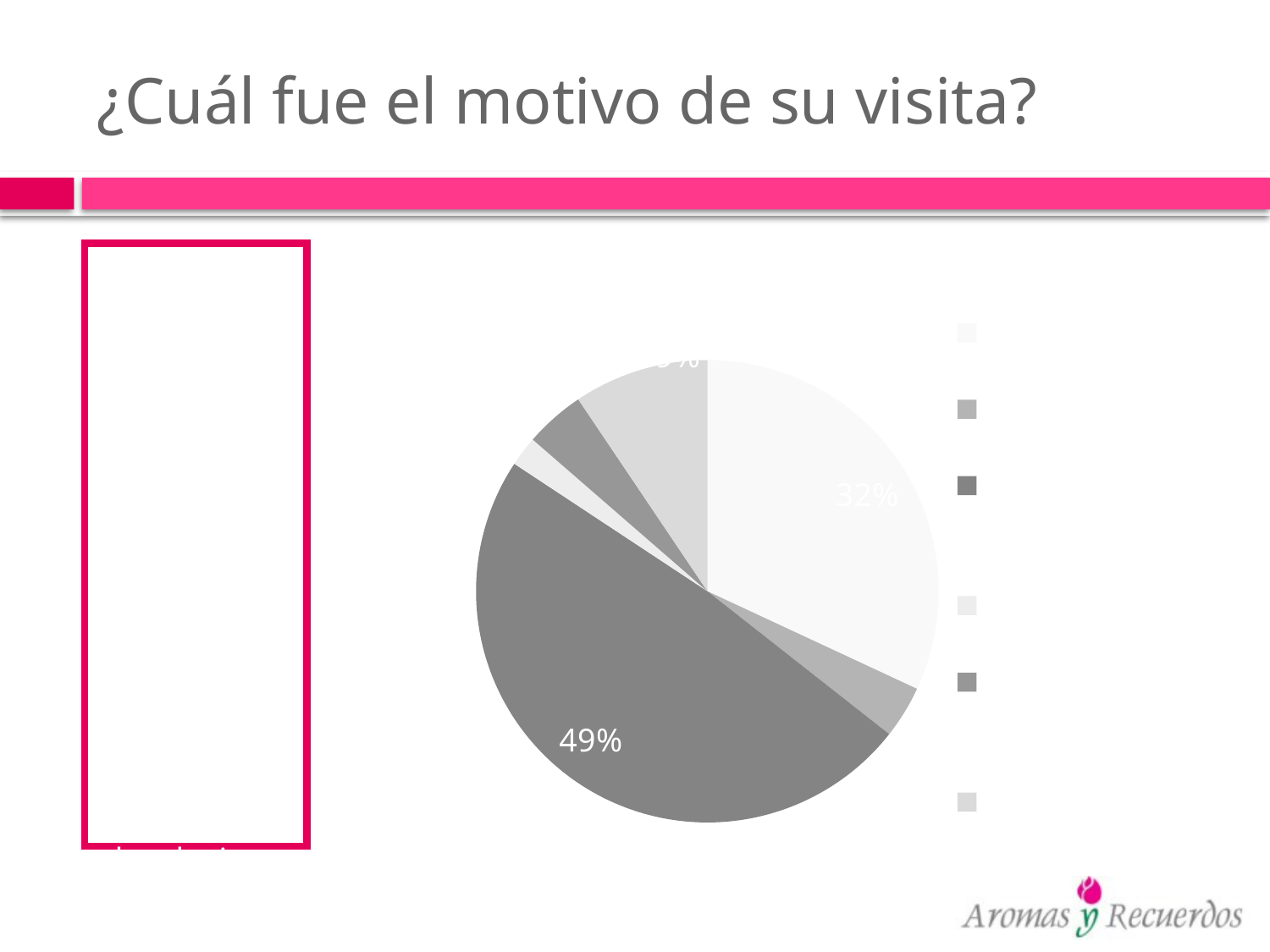
Which is larger: the dark grey slice labelled 49% or the light slice labelled 32%? the dark grey slice (49%) How many entries does the legend of the pie chart list? 6 Is the largest slice of the pie chart greater or less than 50%? less What percentage is shown on the second-largest slice of the pie chart? 32% What kind of chart is shown on the slide? pie chart How many slices does the pie chart have? 6 What is the title of the slide containing the pie chart? ¿Cuál fue el motivo de su visita? What is the difference between the two labelled slices, 49% and 32%? 17 percentage points Together, what share of the pie do the two labelled slices (49% and 32%) make up? 81% What percentage is shown on the largest slice of the pie chart? 49%